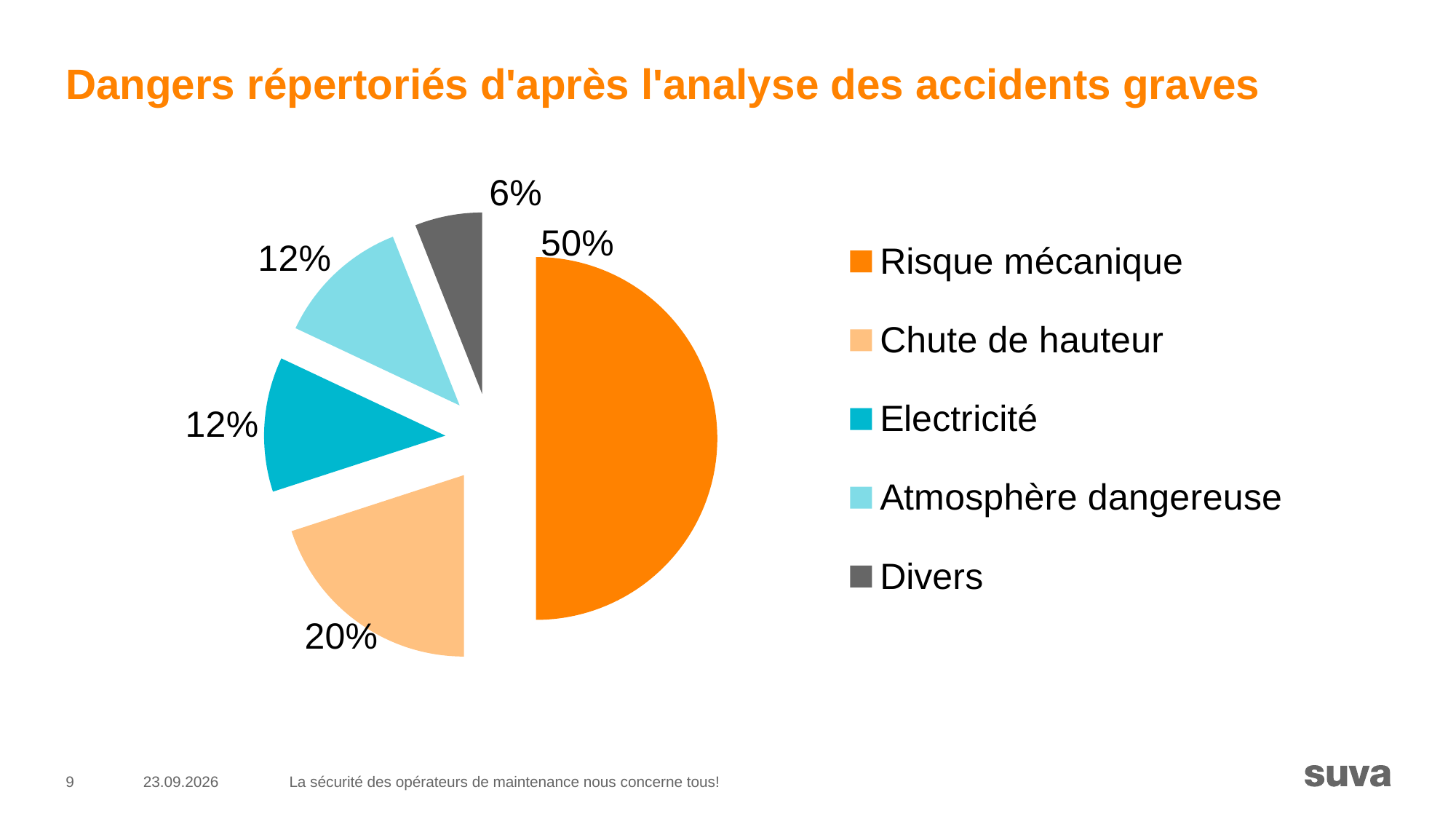
What is the difference between the shares of Risque mécanique and Chute de hauteur? 30% What kind of chart is shown on the slide? Pie chart Which category has the largest slice of the pie? Risque mécanique What is the value shown for Divers? 6% Which category has the smallest slice of the pie? Divers What is the title of the chart? Dangers répertoriés d'après l'analyse des accidents graves What share of the pie does Risque mécanique represent? 50% What is the difference between the shares of Atmosphère dangereuse and Divers? 6% Which is larger, the share for Chute de hauteur or the share for Electricité? Chute de hauteur How many categories does the pie chart show? 5 What is the value shown for Chute de hauteur? 20% What is the value shown for Electricité? 12%